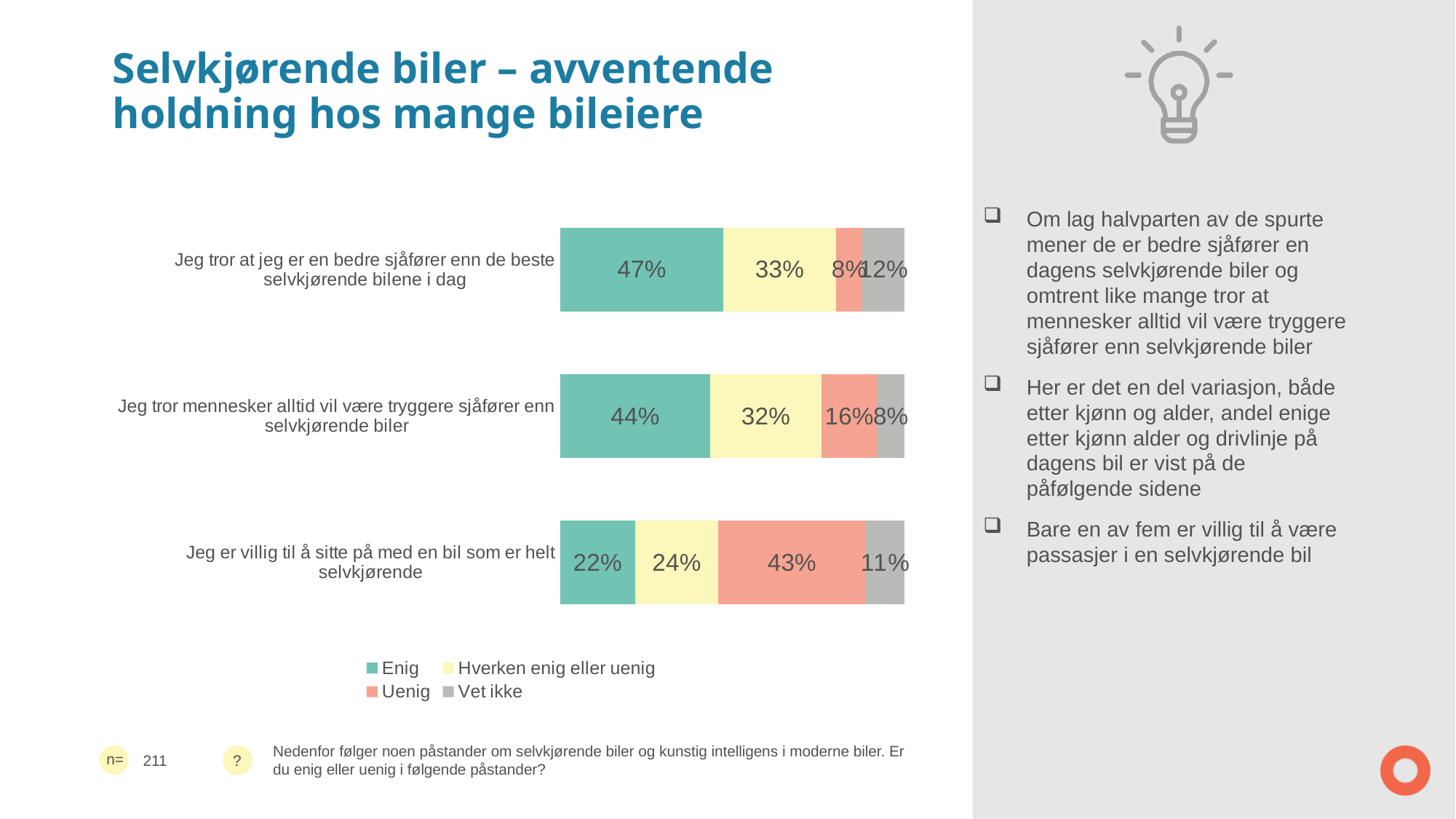
Which statement has the lowest "Enig" share? Jeg er villig til å sitte på med en bil som er helt selvkjørende What is the "Vet ikke" share for the statement "Jeg tror mennesker alltid vil være tryggere sjåfører enn selvkjørende biler"? 8% What is the "Uenig" share for the statement "Jeg er villig til å sitte på med en bil som er helt selvkjørende"? 43% Which statement has the highest "Enig" share? Jeg tror at jeg er en bedre sjåfører enn de beste selvkjørende bilene i dag What percentage of respondents agree (Enig) with the statement "Jeg tror at jeg er en bedre sjåfører enn de beste selvkjørende bilene i dag"? 47% Which is larger: the "Uenig" share for "Jeg tror mennesker alltid vil være tryggere sjåfører enn selvkjørende biler" or the "Uenig" share for "Jeg tror at jeg er en bedre sjåfører enn de beste selvkjørende bilene i dag"? Jeg tror mennesker alltid vil være tryggere sjåfører enn selvkjørende biler What is the difference between the "Enig" share for "Jeg tror at jeg er en bedre sjåfører enn de beste selvkjørende bilene i dag" and the "Enig" share for "Jeg er villig til å sitte på med en bil som er helt selvkjørende"? 25% What kind of chart is shown on the slide? Stacked bar chart What is the sample size (n) shown on the slide? 211 How many series does the legend list? 4 How many statements (categories) are shown in the chart? 3 What is the "Hverken enig eller uenig" share for the statement "Jeg tror at jeg er en bedre sjåfører enn de beste selvkjørende bilene i dag"? 33%